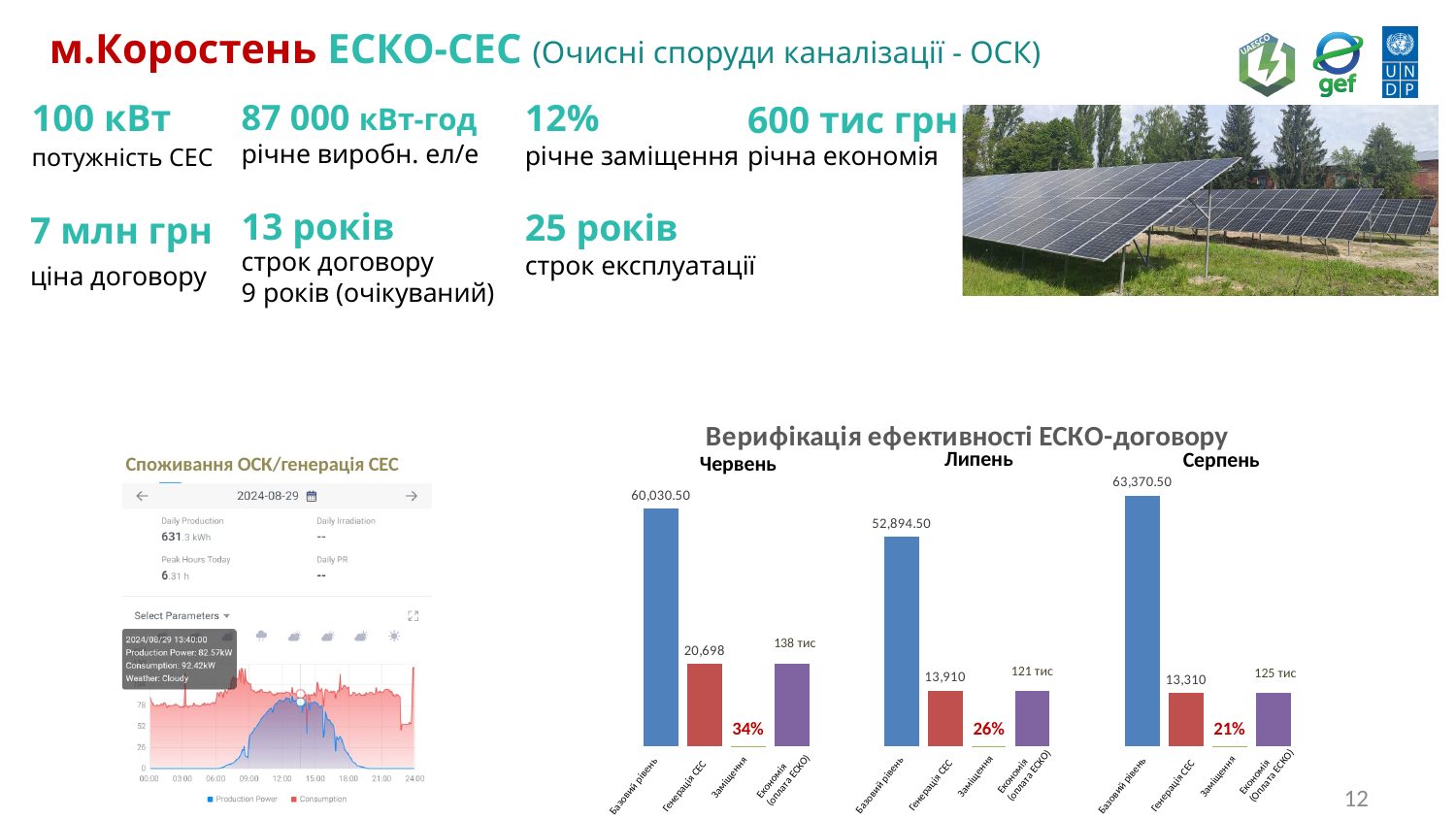
In the Червень chart, what is the value for Базовий рівень? 60,030.50 In the Червень chart, what is the value labelled for Економія (оплата ЕСКО)? 138 тис Is the Генерація СЕС value in the Серпень chart larger or smaller than in the Липень chart? smaller What is the difference between the Генерація СЕС values in the Червень chart and the Липень chart? 6,788 How many categories are shown on the x axis of the Червень chart? 4 In the Липень chart, what is the value for Генерація СЕС? 13,910 How many series does the legend of the Споживання ОСК/генерація СЕС chart on the left list? 2 In the Серпень chart, what percentage is shown for Заміщення? 21% What type of chart is used for the Червень, Липень and Серпень charts? bar chart In the Липень chart, which category has the highest bar? Базовий рівень Which month's chart shows the highest Базовий рівень value: Червень, Липень or Серпень? Серпень In the Серпень chart, what is the value for Базовий рівень? 63,370.50